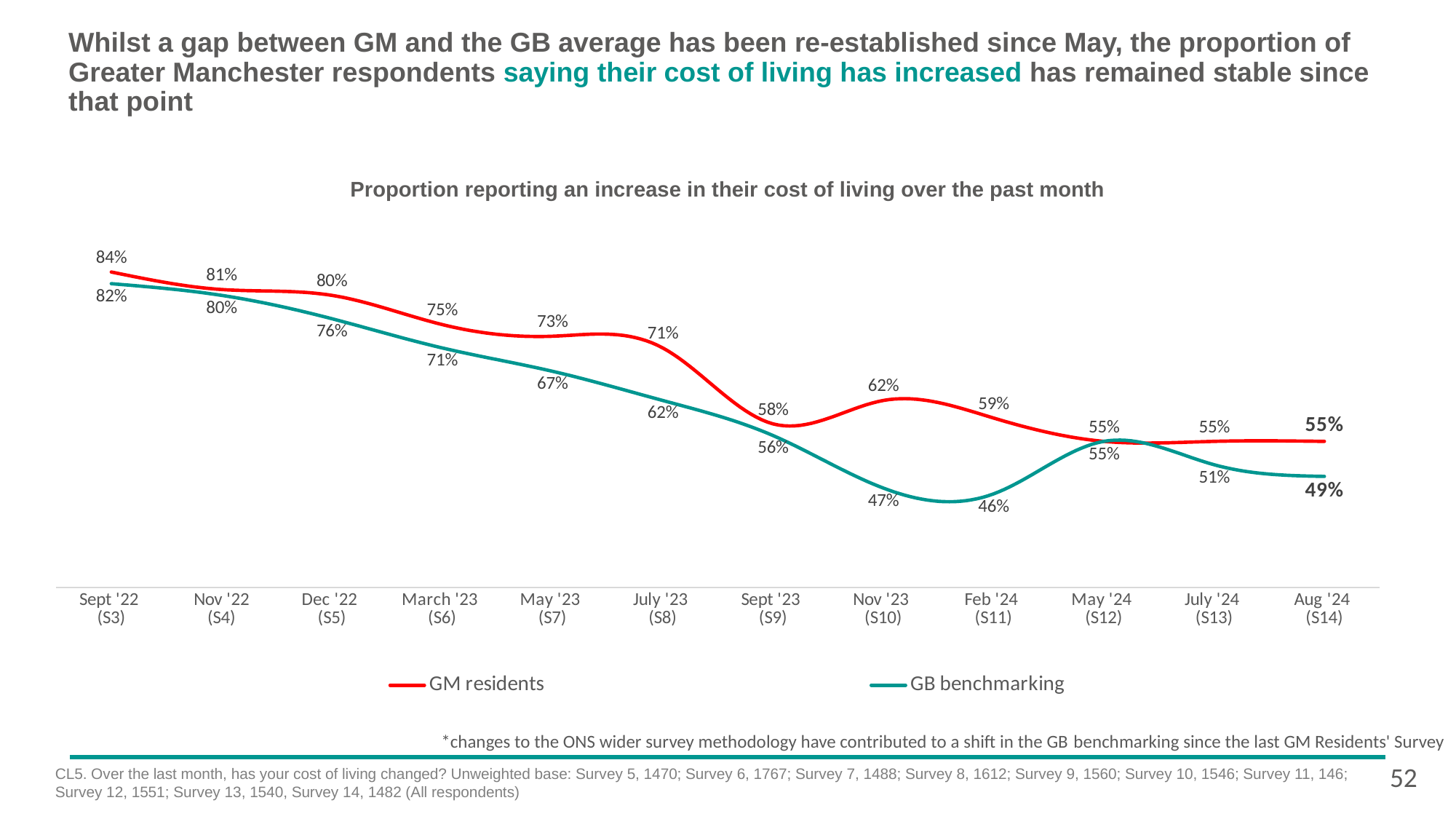
How many survey periods are shown on the x axis? 12 What is the value for GM residents in Aug '24 (S14)? 55% What is the value for GB benchmarking in Feb '24 (S11)? 46% What kind of chart is shown on the slide? Line chart In which survey period is the GB benchmarking value lowest? Feb '24 (S11) What is the value for GB benchmarking in Aug '24 (S14)? 49% Which series has the higher value in July '24 (S13), GM residents or GB benchmarking? GM residents In which survey period is the GM residents value highest? Sept '22 (S3) What is the difference between the GM residents and GB benchmarking values in Nov '23 (S10)? 15 percentage points What is the value for GM residents in Nov '23 (S10)? 62% How many series does the legend list? 2 Does the GM residents value generally rise or fall from Sept '22 to Aug '24? Fall